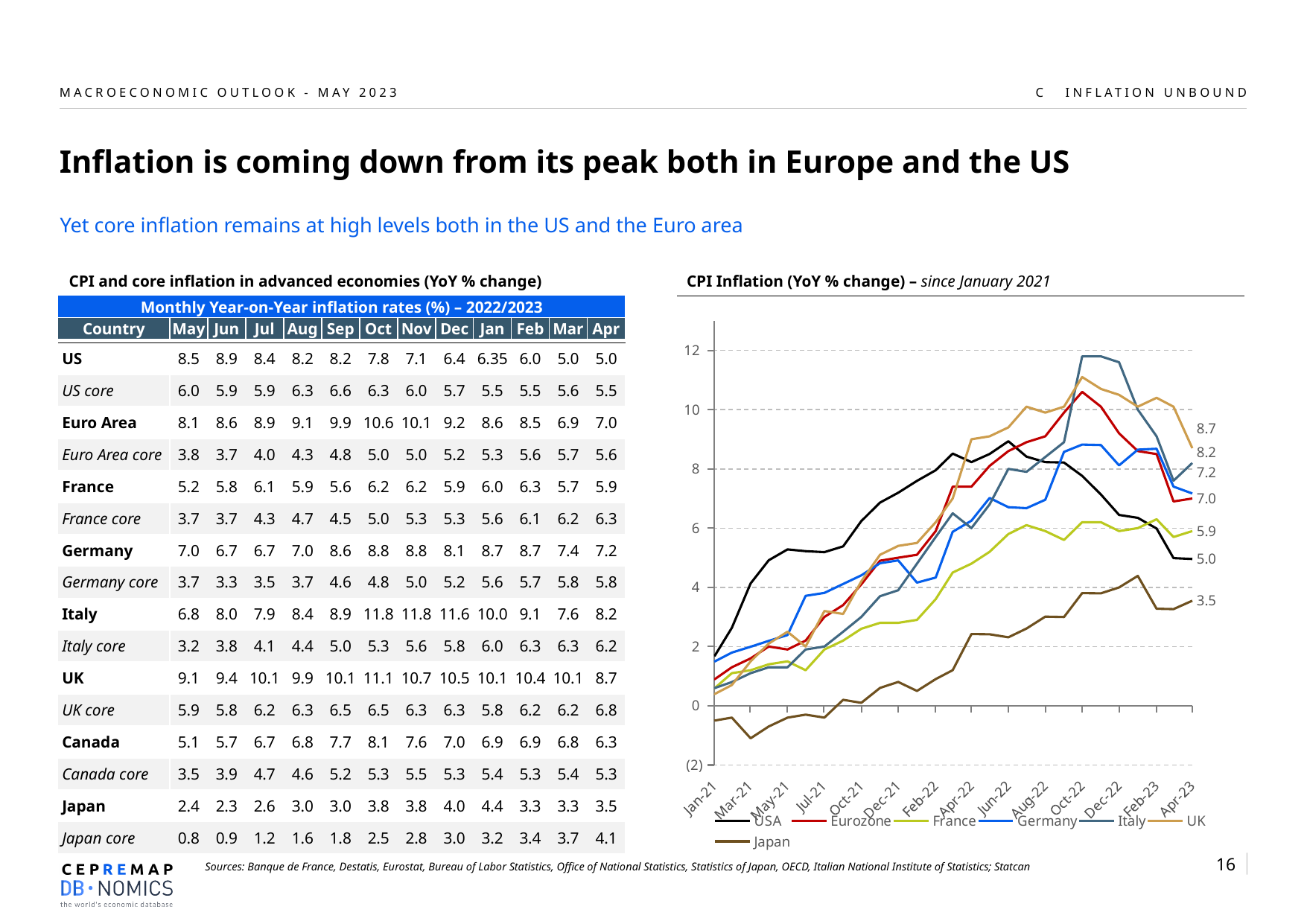
In the CPI Inflation chart, which series has the lowest value at the end of the period (Apr-23)? Japan What kind of chart is the 'CPI Inflation (YoY % change) – since January 2021' chart? line chart In the CPI Inflation chart, what is the value labelled at the end of the UK line? 8.7 In the CPI Inflation chart, which is larger at the end of the period: the Italy value or the Germany value? Italy In the CPI Inflation chart, what is the value labelled at the end of the USA line? 5.0 In the CPI Inflation chart, is the peak of the Italy line greater or less than 10? greater In the CPI Inflation chart, what is the difference between the end-of-period values of the UK and Japan lines? 5.2 What is the title of the line chart on the right of the slide? CPI Inflation (YoY % change) – since January 2021 In the CPI Inflation chart, which series has the highest value at the end of the period (Apr-23)? UK In the CPI Inflation chart, what is the value labelled at the end of the Japan line? 3.5 In the CPI Inflation chart, does the USA line rise or fall between Jun-22 and Apr-23? fall How many series does the legend of the CPI Inflation chart list? 7